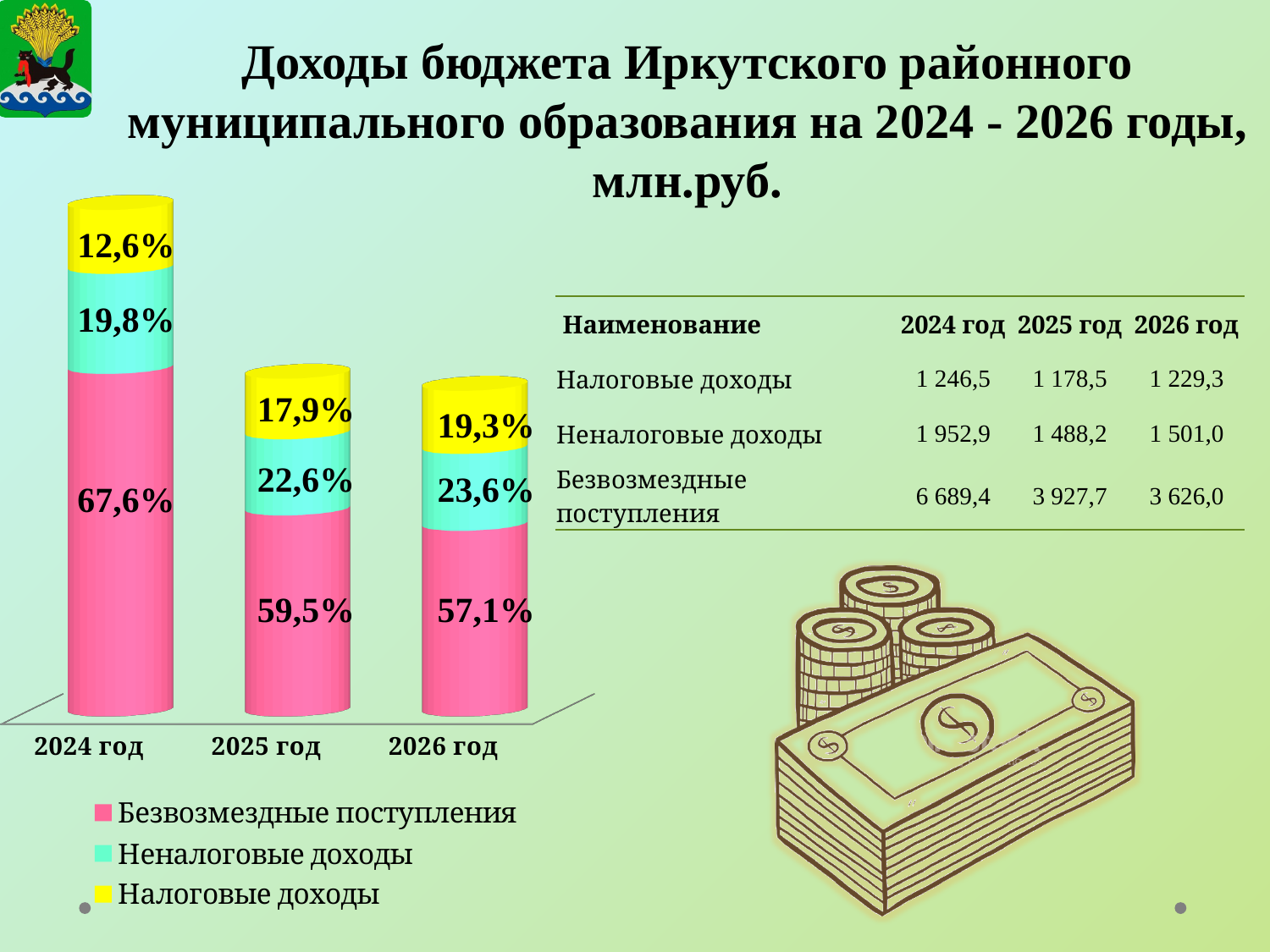
Which is larger: the share of Неналоговые доходы in 2026 год or the share of Налоговые доходы in 2026 год? Неналоговые доходы In which year is the share of Безвозмездные поступления the highest? 2024 год What is the share of Налоговые доходы in 2026 год? 19,3% Does the share of Безвозмездные поступления rise or fall from 2024 год to 2026 год? Fall What is the share of Неналоговые доходы in 2025 год? 22,6% How many years are shown on the x axis of the chart? 3 How many series does the chart legend list? 3 What is the difference between the share of Безвозмездные поступления in 2024 год and in 2026 год? 10,5% In which year is the share of Налоговые доходы the lowest? 2024 год What is the share of Безвозмездные поступления in 2024 год? 67,6% What kind of chart is shown on the slide? Stacked bar chart Which colour represents Налоговые доходы in the chart? Yellow